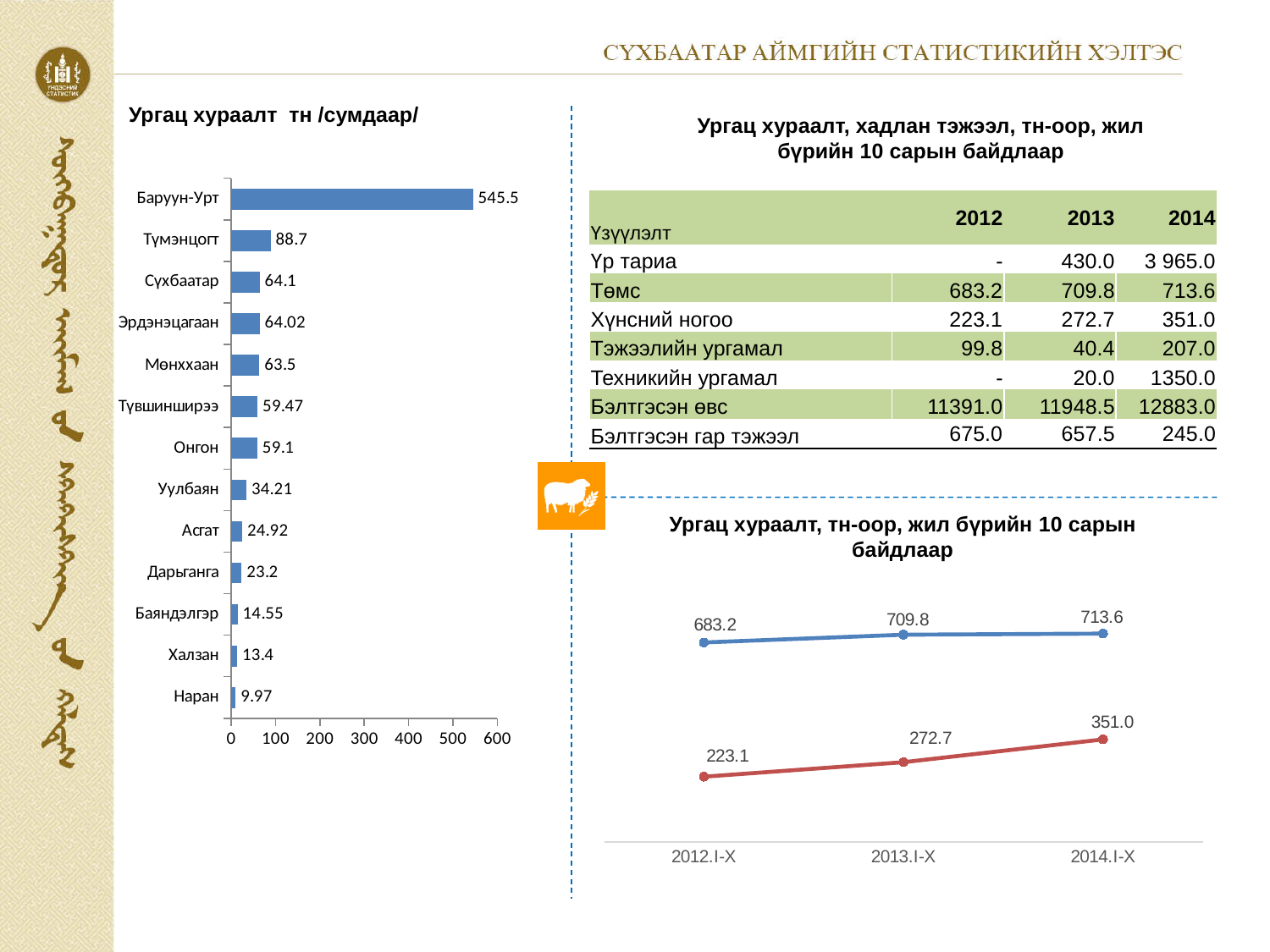
In the line chart 'Ургац хураалт, тн-оор, жил бүрийн 10 сарын байдлаар', what is the value of the red line at 2014.I-X? 351.0 In the bar chart 'Ургац хураалт тн /сумдаар/', what is the value for Баруун-Урт? 545.5 In the bar chart 'Ургац хураалт тн /сумдаар/', which is larger, the value for Дарьганга or the value for Асгат? Асгат What kind of chart is 'Ургац хураалт тн /сумдаар/'? Bar chart In the line chart 'Ургац хураалт, тн-оор, жил бүрийн 10 сарын байдлаар', what is the difference between the blue line values at 2014.I-X and 2012.I-X? 30.4 In the line chart 'Ургац хураалт, тн-оор, жил бүрийн 10 сарын байдлаар', does the red line rise or fall from 2012.I-X to 2014.I-X? Rise In the bar chart 'Ургац хураалт тн /сумдаар/', how many categories are shown? 13 In the bar chart 'Ургац хураалт тн /сумдаар/', which category has the lowest value? Наран In the line chart 'Ургац хураалт, тн-оор, жил бүрийн 10 сарын байдлаар', what is the value of the blue line at 2013.I-X? 709.8 In the bar chart 'Ургац хураалт тн /сумдаар/', what is the value for Уулбаян? 34.21 In the bar chart 'Ургац хураалт тн /сумдаар/', what is the difference between the values for Түмэнцогт and Сүхбаатар? 24.6 In the bar chart 'Ургац хураалт тн /сумдаар/', which category has the highest value? Баруун-Урт